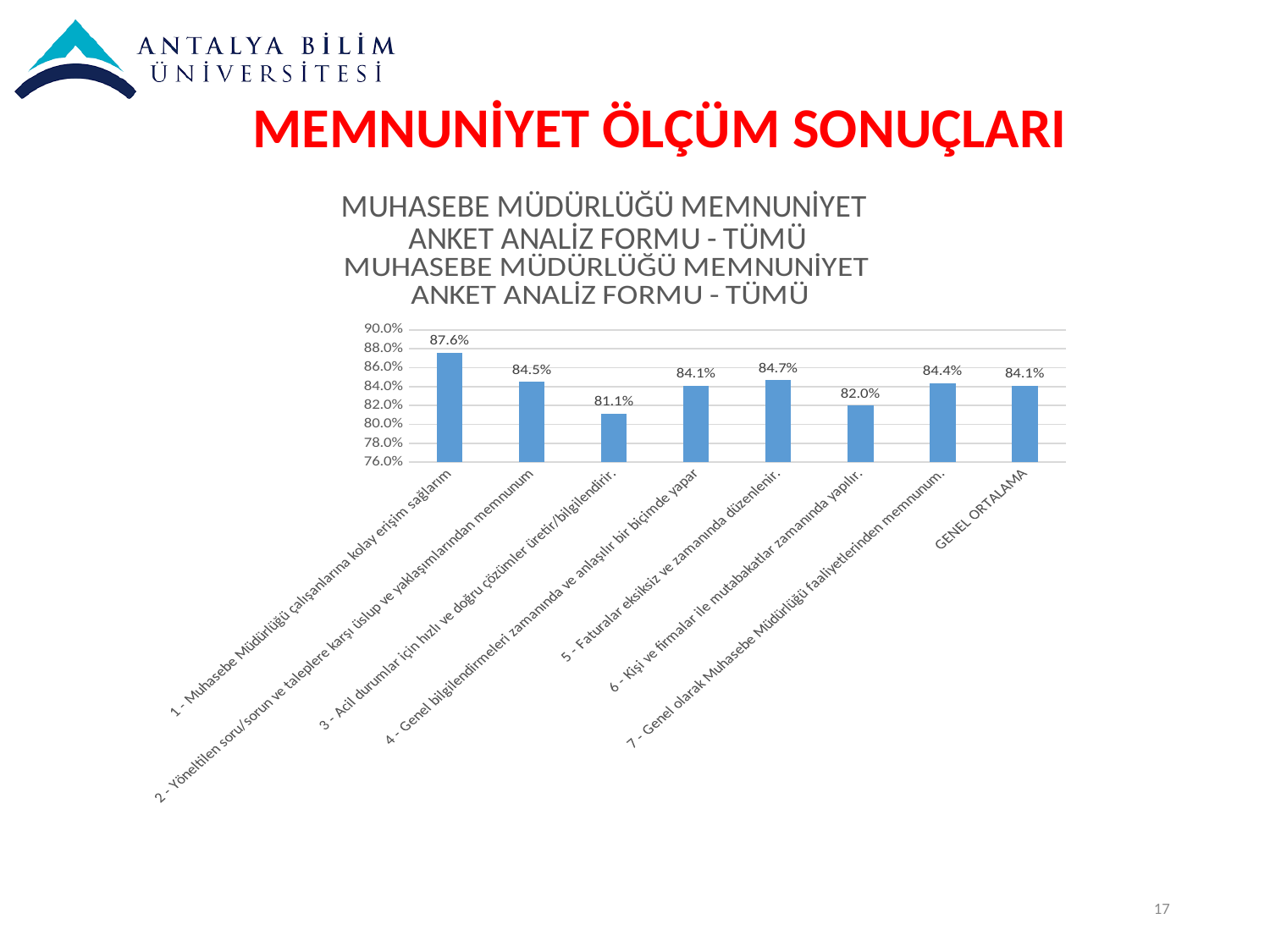
Which category has the highest value? 1 - Muhasebe Müdürlüğü çalışanlarına kolay erişim sağlarım Is the value for item 2, 'Yöneltilen soru/sorun ve taleplere karşı üslup ve yaklaşımlarından memnunum', greater or less than 84.0%? greater What type of chart is shown on the slide? Bar chart Which category has the lowest value? 3 - Acil durumlar için hızlı ve doğru çözümler üretir/bilgilendirir. What is the value for item 1, 'Muhasebe Müdürlüğü çalışanlarına kolay erişim sağlarım'? 87.6% What is the difference between the value for item 1 (87.6%) and item 3 (81.1%)? 6.5% What is the value for item 6, 'Kişi ve firmalar ile mutabakatlar zamanında yapılır.'? 82.0% What is the value for 'GENEL ORTALAMA'? 84.1% How many bars are plotted in the chart? 8 What is the title of the chart? MUHASEBE MÜDÜRLÜĞÜ MEMNUNİYET ANKET ANALİZ FORMU - TÜMÜ Which is larger: the value for item 5 'Faturalar eksiksiz ve zamanında düzenlenir.' or item 6 'Kişi ve firmalar ile mutabakatlar zamanında yapılır.'? Item 5 (84.7%) What is the value for item 3, 'Acil durumlar için hızlı ve doğru çözümler üretir/bilgilendirir.'? 81.1%